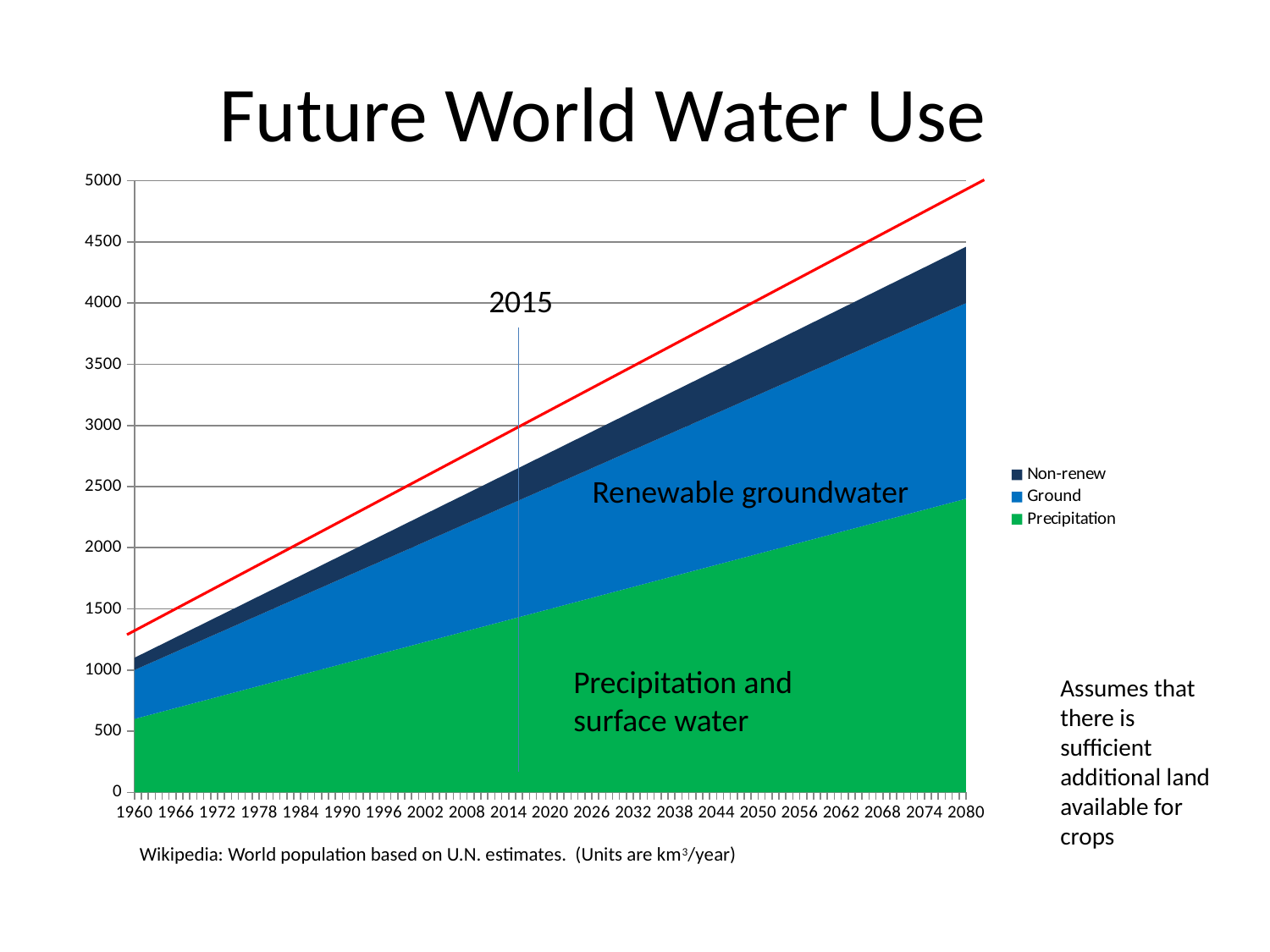
Is the total height of the stacked areas at 1960 greater or less than 1000? greater Is the total height of the stacked areas at 2080 greater or less than 4000? greater What year is marked by the vertical line label on the chart? 2015 Which series is shown in green in the legend? Precipitation Which of the three stacked series has the thinnest band across the chart? Non-renew What kind of chart is shown on the slide? Stacked area chart Is the value of the Precipitation area at 2080 greater or less than 2000? greater Do the stacked values rise or fall from 1960 to 2080? Rise What is the title of the chart? Future World Water Use How many series does the legend list? 3 At 2080, which is larger: the Precipitation band or the Ground band? Precipitation